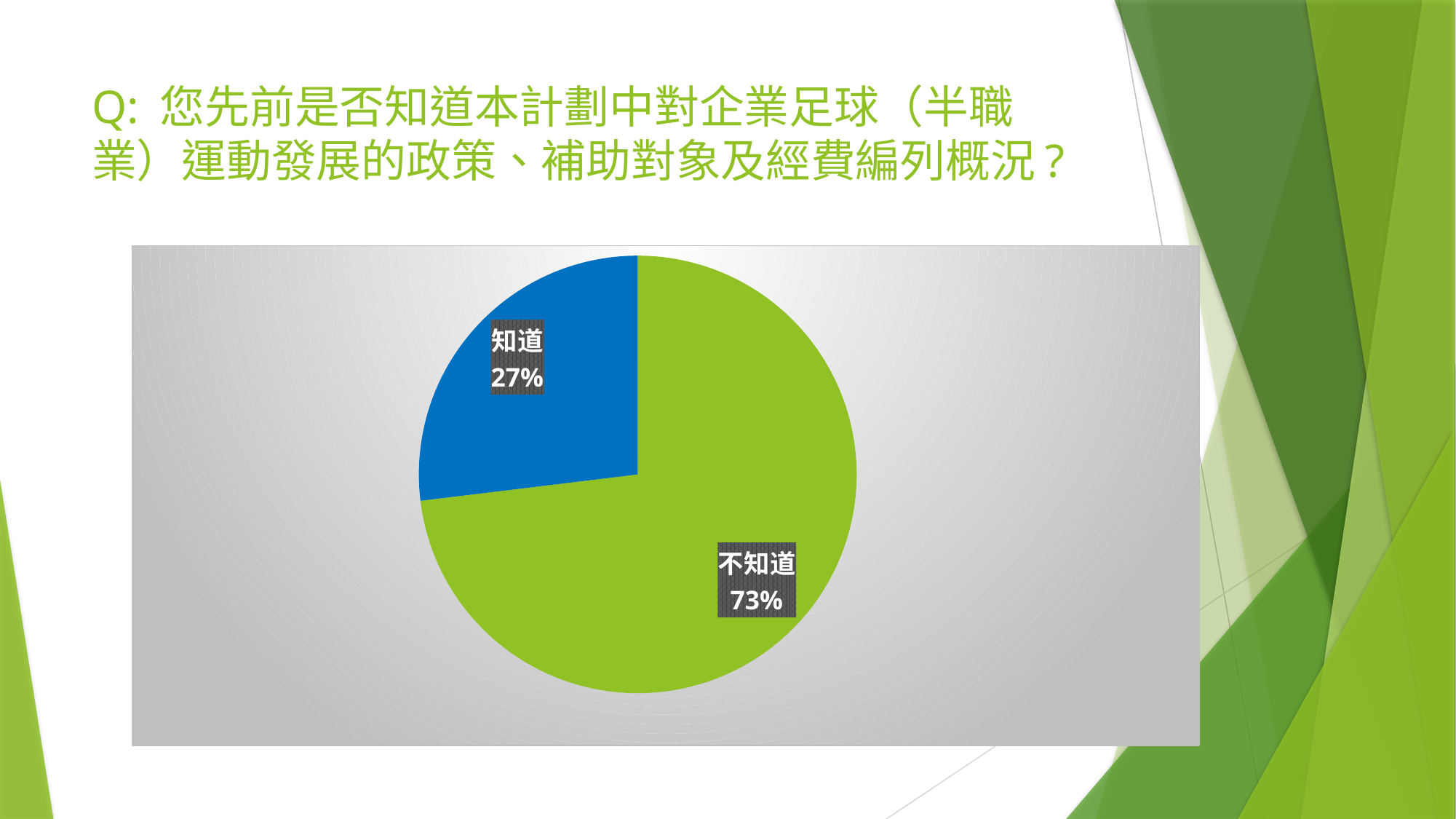
What is the difference in percentage points between 不知道 and 知道? 46 Which category has the smallest share of the pie? 知道 What percentage of respondents answered 不知道? 73% What colour is the 知道 slice? Blue How many slices does the pie chart have? 2 Which is larger, the share for 知道 or the share for 不知道? 不知道 What share of the pie does the 不知道 slice represent? 73% Which category has the largest share of the pie? 不知道 What colour is the 不知道 slice? Green What kind of chart is shown on the slide? Pie chart What percentage of respondents answered 知道? 27%